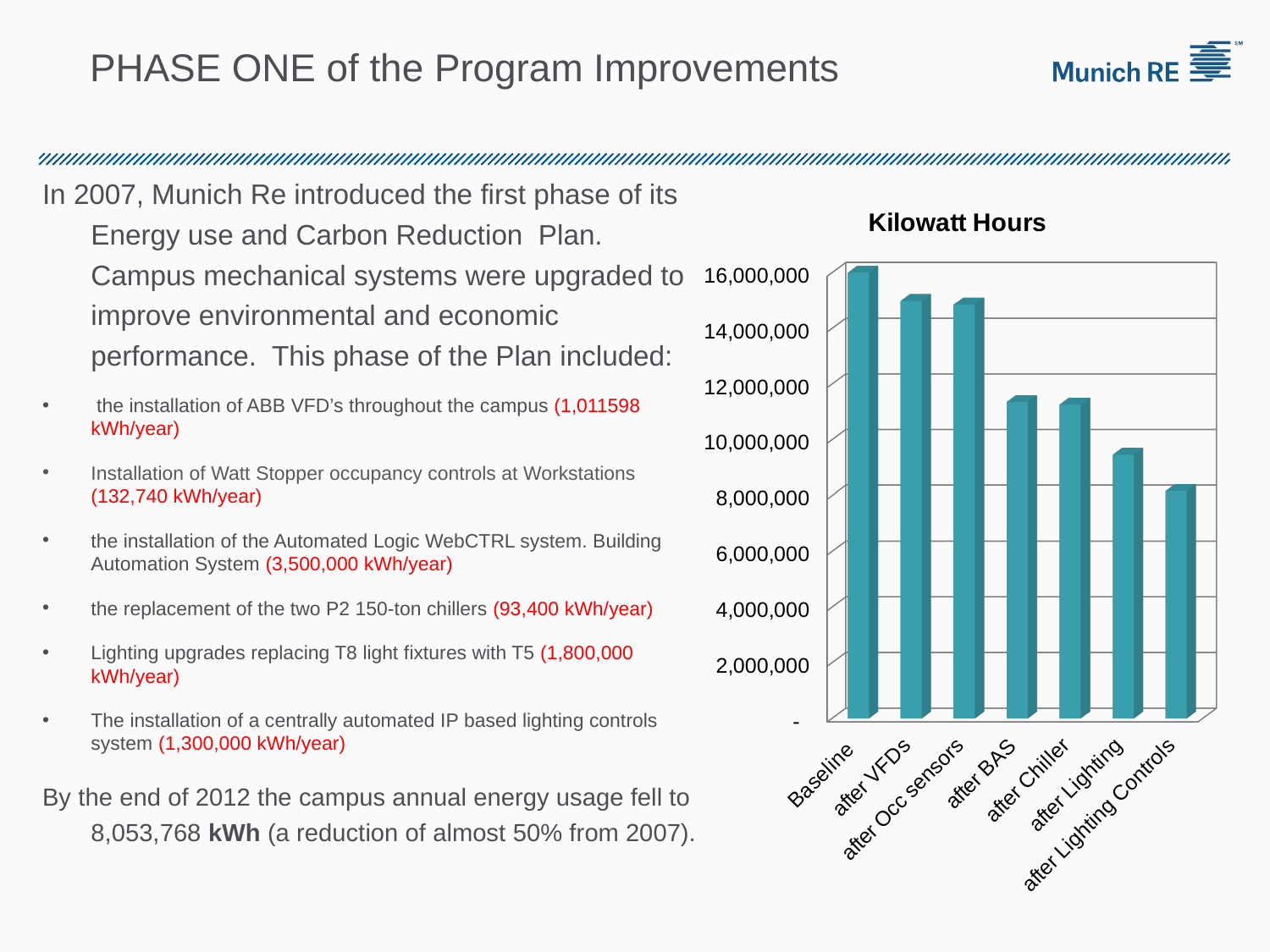
Is the value for after Lighting Controls greater or less than 10,000,000? less How many categories are plotted on the x axis of the chart? 7 Is the value for Baseline greater or less than 14,000,000? greater Is the value for after Chiller greater or less than 10,000,000? greater What is the title of the chart? Kilowatt Hours Which category has the highest value in the chart? Baseline Which category has the lowest value in the chart? after Lighting Controls Which is larger, the value for Baseline or the value for after BAS? Baseline What kind of chart is shown on the slide? bar chart Do the values rise or fall moving from left to right along the x axis? fall